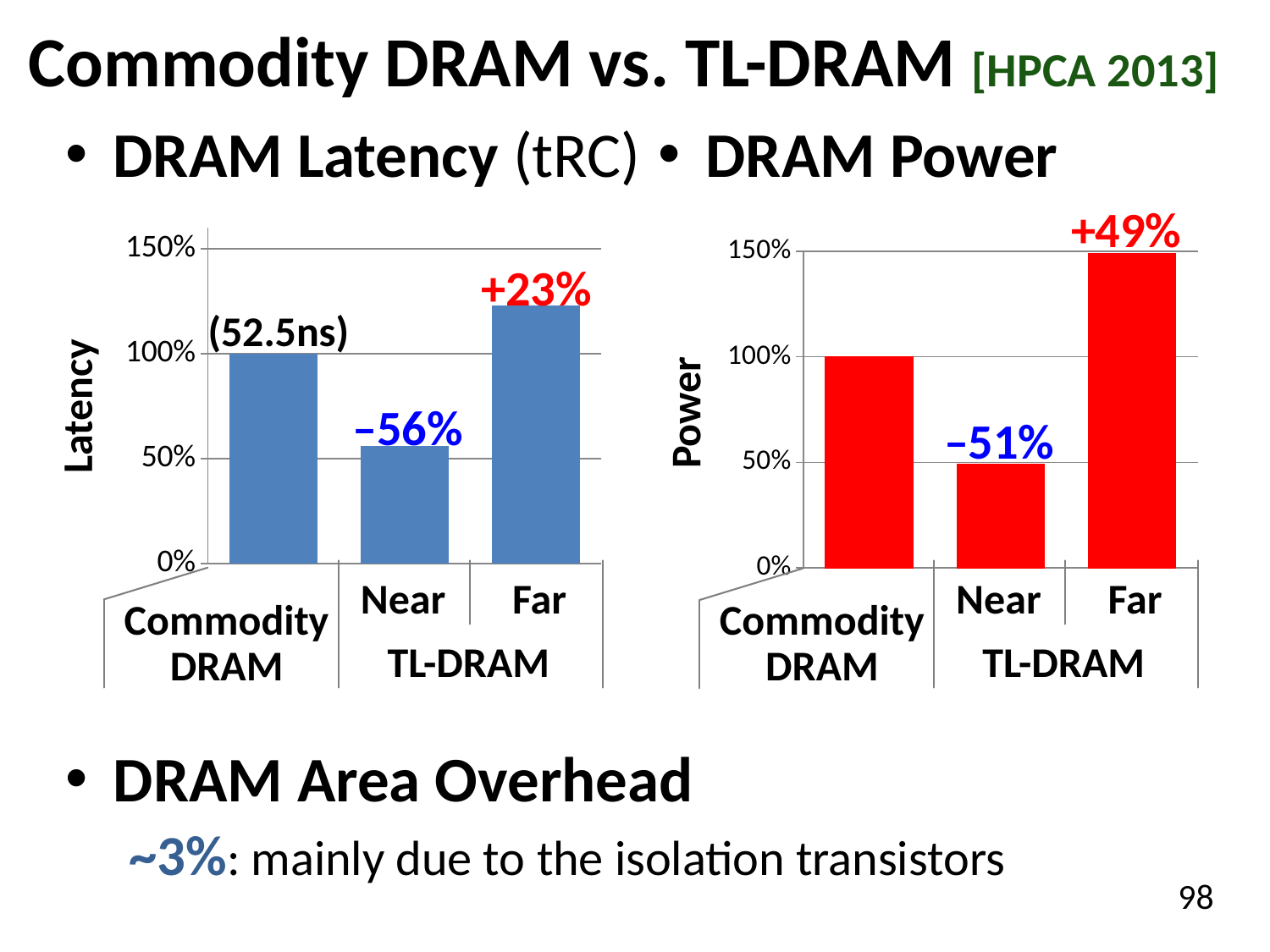
In the DRAM Power chart, which bar is the highest? Far In the DRAM Latency chart, what percentage change is printed above the Far bar of TL-DRAM? +23% What kind of chart is the DRAM Latency chart on the left? bar chart In the DRAM Latency chart, is the value for Near greater or less than 50%? greater In the DRAM Power chart, is the value for Far greater or less than 100%? greater In the DRAM Latency chart, what absolute latency is printed above the Commodity DRAM bar? 52.5ns In the DRAM Latency chart, what is the latency value for Commodity DRAM? 100% How many bars does the DRAM Power chart have? 3 In the DRAM Power chart, what is the power value for Commodity DRAM? 100% In the DRAM Latency chart, which bar is the lowest? Near In the DRAM Power chart, what percentage change is printed above the Far bar of TL-DRAM? +49% In the DRAM Latency chart, what percentage change is printed above the Near bar of TL-DRAM? –56%